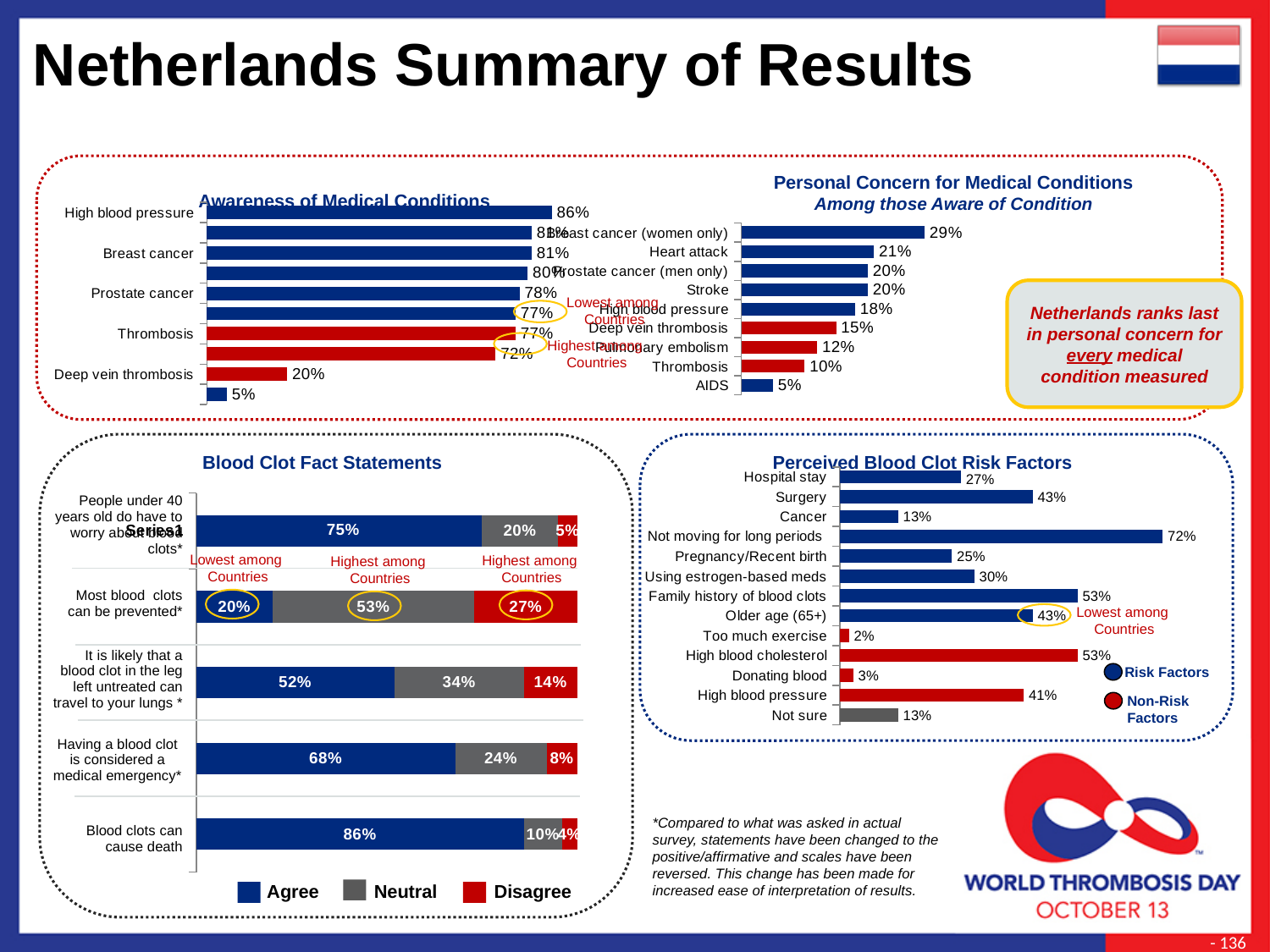
In the Perceived Blood Clot Risk Factors chart, what is the value for Not moving for long periods? 72% In the Blood Clot Fact Statements chart, how many series does the legend list? 3 In the Personal Concern for Medical Conditions chart, which condition has the highest value? Breast cancer (women only) In the Perceived Blood Clot Risk Factors chart, what is the difference between Surgery and Cancer? 30% In the Personal Concern for Medical Conditions chart, what is the value for Heart attack? 21% In the Blood Clot Fact Statements chart, what is the Neutral value for 'Most blood clots can be prevented'? 53% What kind of chart is the Awareness of Medical Conditions chart? Bar chart In the Perceived Blood Clot Risk Factors chart, which factor has the lowest value? Too much exercise In the Blood Clot Fact Statements chart, which is larger: the Agree value for 'Having a blood clot is considered a medical emergency' or the Agree value for 'It is likely that a blood clot in the leg left untreated can travel to your lungs'? Having a blood clot is considered a medical emergency In the Personal Concern for Medical Conditions chart, how many conditions are listed? 9 In the Blood Clot Fact Statements chart, what percentage agree that blood clots can cause death? 86% In the Personal Concern for Medical Conditions chart, what is the difference between Stroke and AIDS? 15%